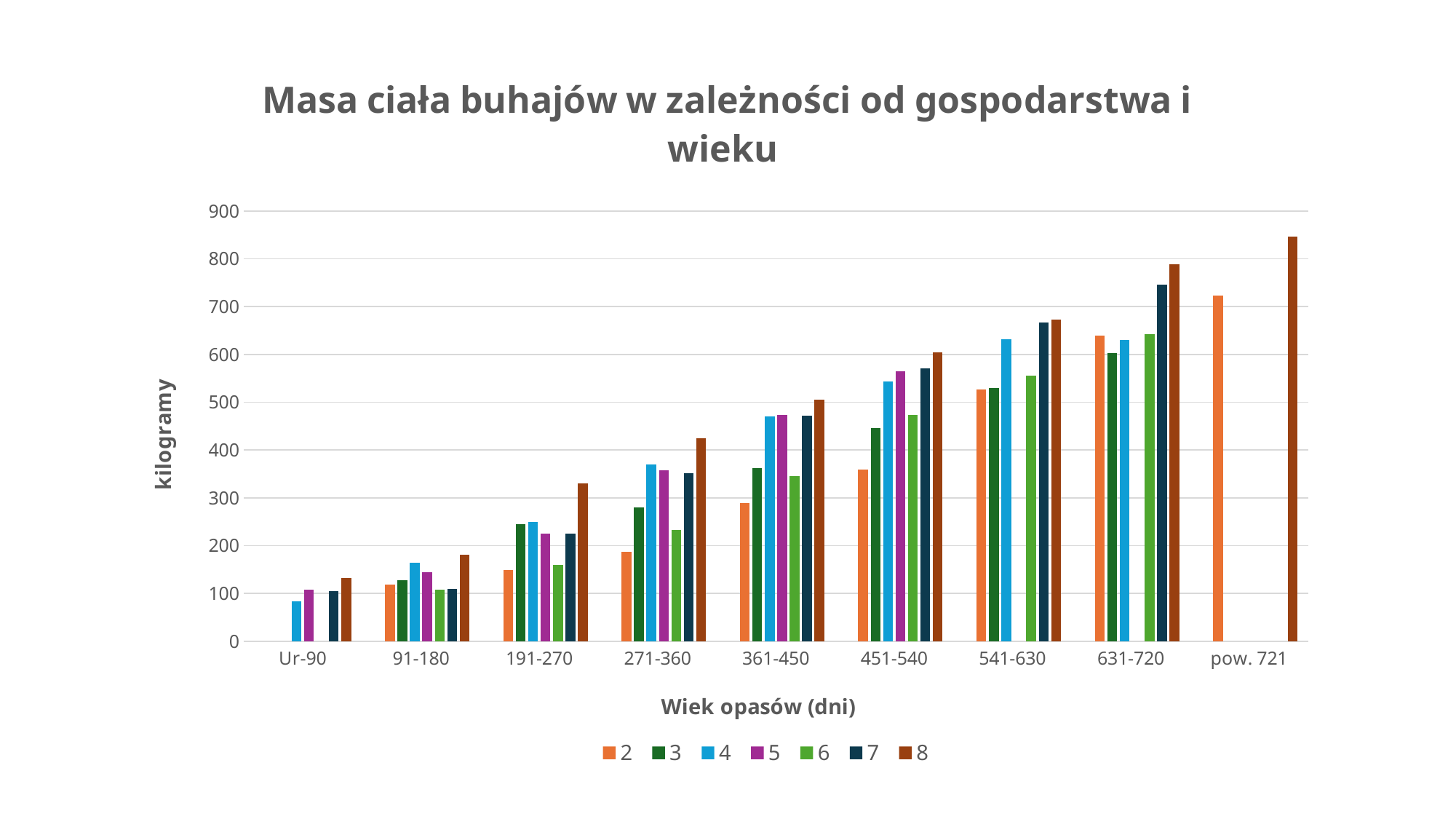
Is the value for series 4 in the 'Ur-90' category greater or less than 100? less How many age categories are shown on the x axis? 9 In the '541-630' category, which is larger: the value for series 4 or series 6? 4 What is the label of the y axis? kilogramy Is the value for series 2 in the '361-450' category greater or less than 300? less How many series does the legend list? 7 Do the values for series 8 rise or fall as age increases along the x axis? rise Which series has the lowest value in the '271-360' category? 2 Which series has the highest value in the '631-720' category? 8 Is the value for series 8 in the 'pow. 721' category greater or less than 800? greater What type of chart is shown on the slide? bar chart